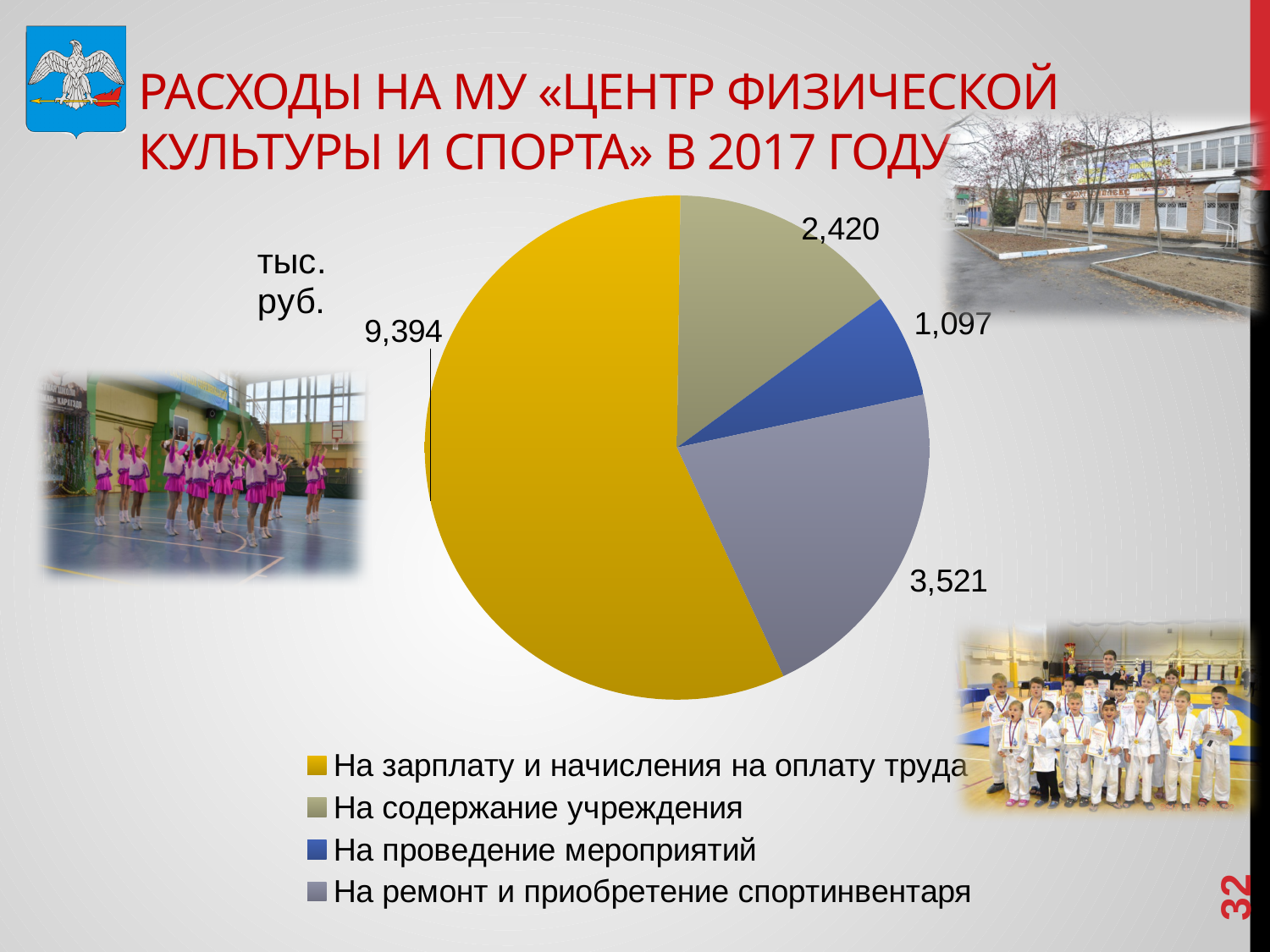
Which category has the largest slice of the pie? На зарплату и начисления на оплату труда What type of chart is shown on the slide? Pie chart What is the value for «На содержание учреждения»? 2,420 What is the value for «На зарплату и начисления на оплату труда»? 9,394 What is the value for «На ремонт и приобретение спортинвентаря»? 3,521 Which is larger: the value for «На содержание учреждения» or «На ремонт и приобретение спортинвентаря»? На ремонт и приобретение спортинвентаря What is the difference between the values for «На зарплату и начисления на оплату труда» and «На ремонт и приобретение спортинвентаря»? 5,873 How many entries does the legend list? 4 Which category has the smallest slice of the pie? На проведение мероприятий How many slices does the pie chart have? 4 In what units are the values on the chart given? тыс. руб. What is the value for «На проведение мероприятий»? 1,097